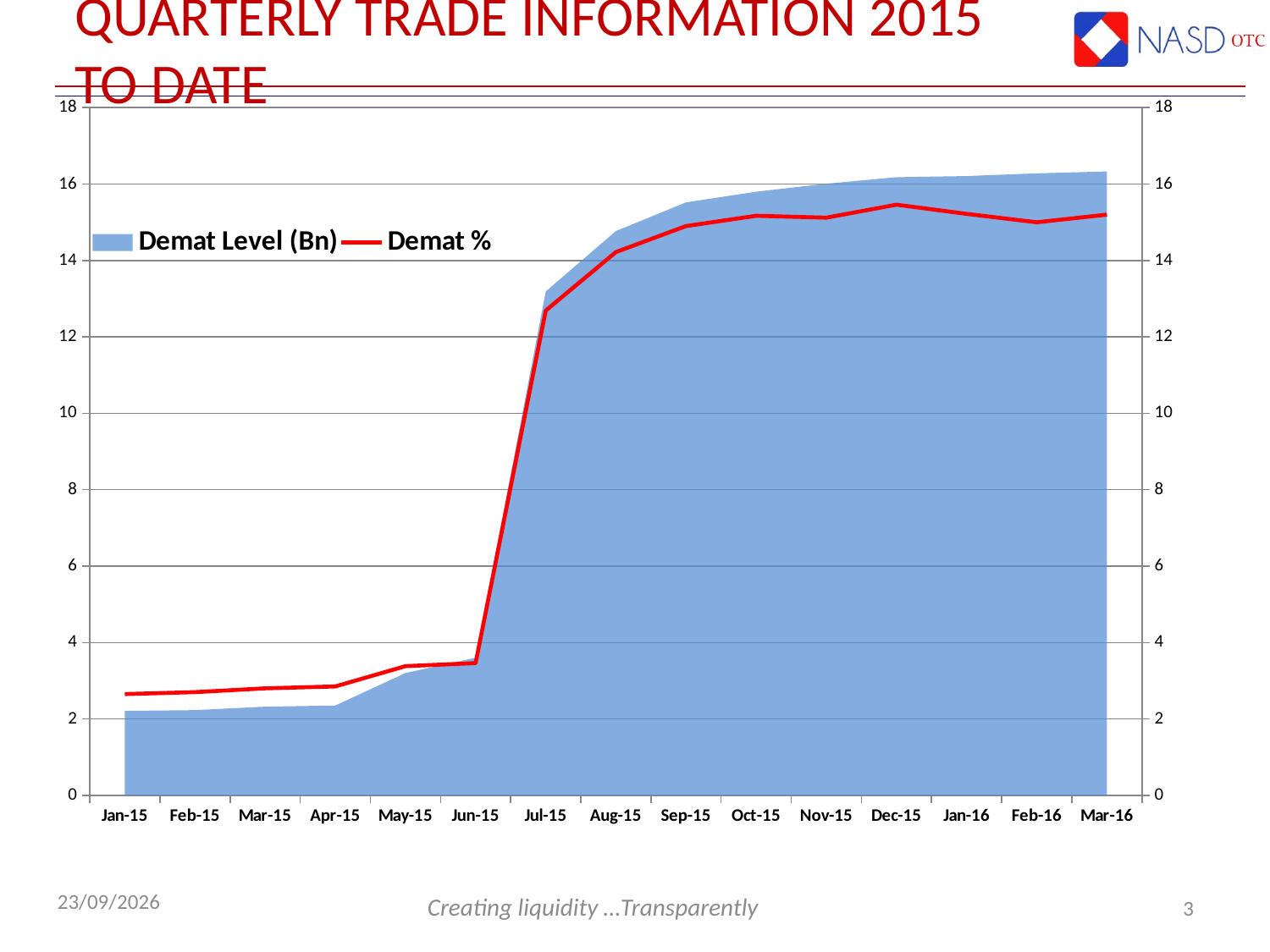
Is the Demat % for Jan-15 greater or less than 4? less What kind of chart is shown on the slide? A combined area and line chart Is the Demat % for Sep-15 greater or less than 14? greater How many series does the chart legend list? 2 Which month has the highest Demat Level (Bn)? Mar-16 Is the Demat Level (Bn) for Jun-15 greater or less than 4? less Which is larger, the Demat Level (Bn) for Jun-15 or for Jul-15? Jul-15 How many months are shown on the x axis of the chart? 15 Which month has the highest Demat %? Dec-15 What colour is the Demat % line in the chart? Red Does the Demat Level (Bn) generally rise or fall from Jan-15 to Mar-16? rise